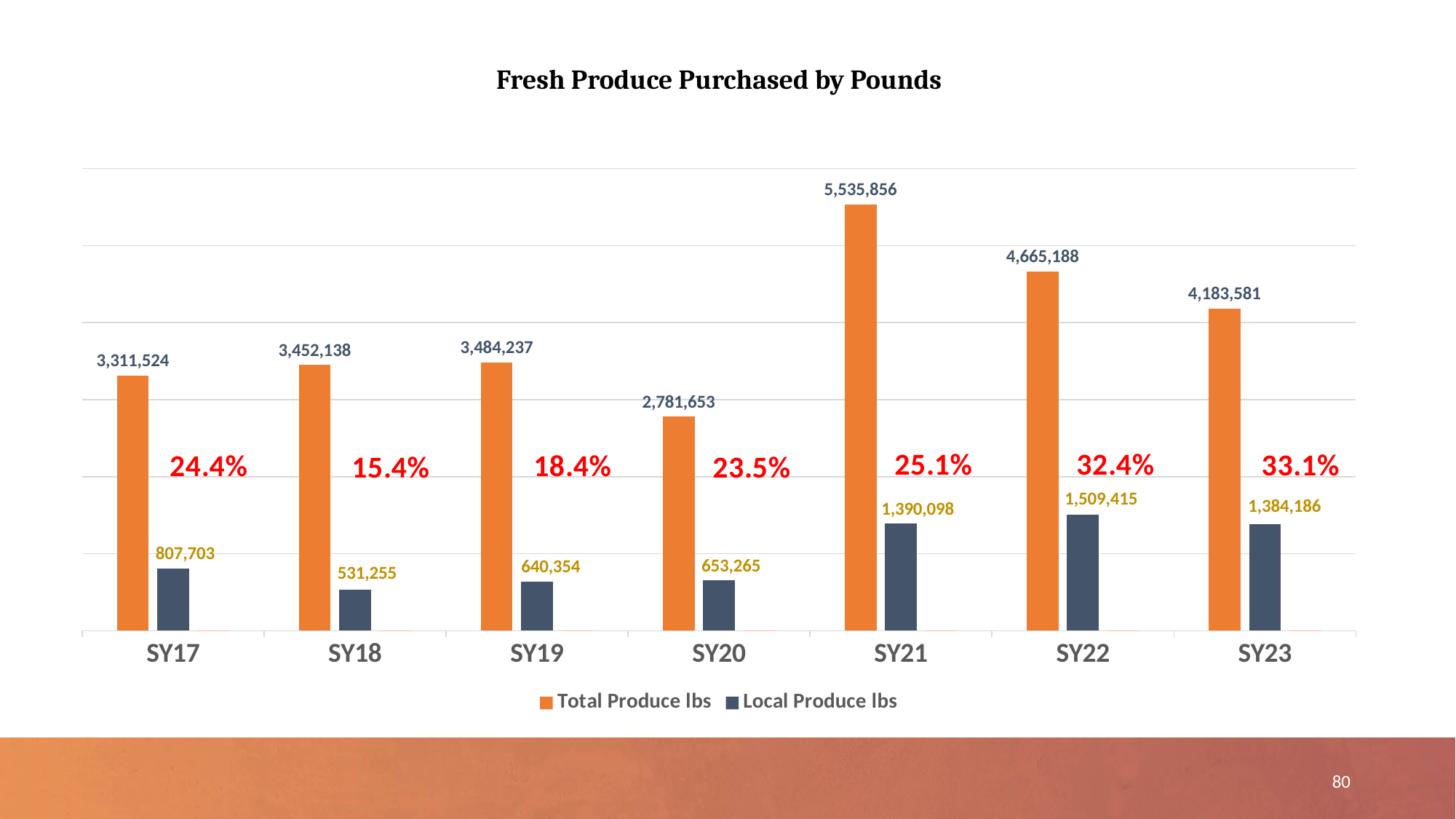
What type of chart is shown on the slide? Bar chart Which is larger, Local Produce lbs in SY22 or in SY23? SY22 How many series does the legend list? 2 What is the Total Produce lbs value for SY21? 5,535,856 Which school year has the lowest Local Produce lbs? SY18 What percentage is shown in red for SY23? 33.1% What is the title of the chart? Fresh Produce Purchased by Pounds What is the Local Produce lbs value for SY18? 531,255 How many school years are shown on the x axis? 7 Which school year has the highest Total Produce lbs? SY21 Do the Total Produce lbs values rise or fall from SY21 to SY23? Fall What is the difference between Total Produce lbs in SY21 and SY20? 2,754,203